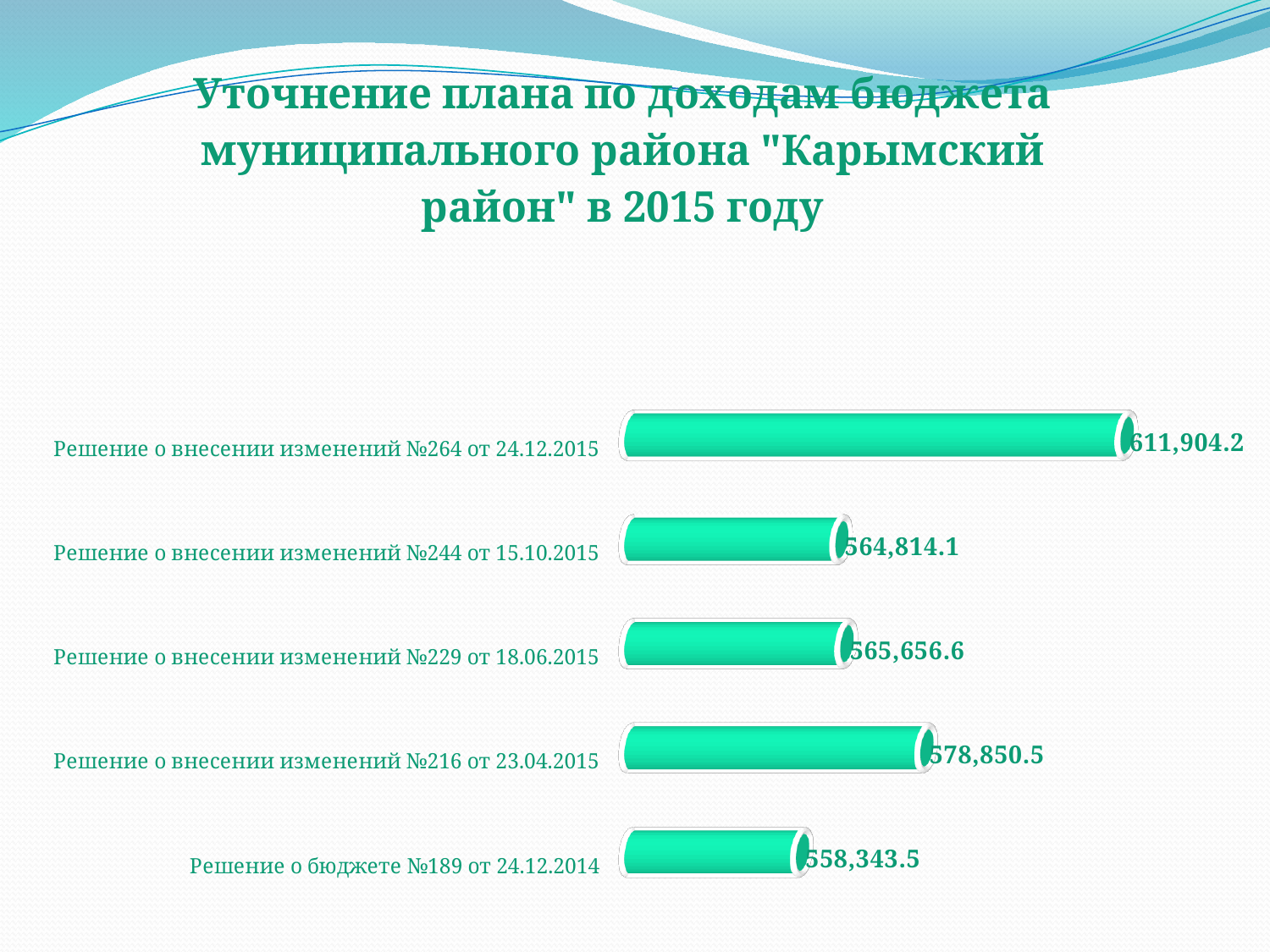
What is the value for "Решение о бюджете №189 от 24.12.2014"? 558,343.5 What is the difference between the value for "Решение о внесении изменений №216 от 23.04.2015" and the value for "Решение о бюджете №189 от 24.12.2014"? 20,507.0 What kind of chart is shown on the slide? Bar chart What is the value for "Решение о внесении изменений №216 от 23.04.2015"? 578,850.5 Which is larger: the value for "Решение о внесении изменений №216 от 23.04.2015" or the value for "Решение о внесении изменений №244 от 15.10.2015"? Решение о внесении изменений №216 от 23.04.2015 What is the difference between the value for "Решение о внесении изменений №264 от 24.12.2015" and the value for "Решение о бюджете №189 от 24.12.2014"? 53,560.7 Which category has the lowest value? Решение о бюджете №189 от 24.12.2014 What is the title of the slide? Уточнение плана по доходам бюджета муниципального района "Карымский район" в 2015 году What is the value for "Решение о внесении изменений №264 от 24.12.2015"? 611,904.2 How many categories are shown in the chart? 5 What is the value for "Решение о внесении изменений №229 от 18.06.2015"? 565,656.6 Which category has the highest value? Решение о внесении изменений №264 от 24.12.2015